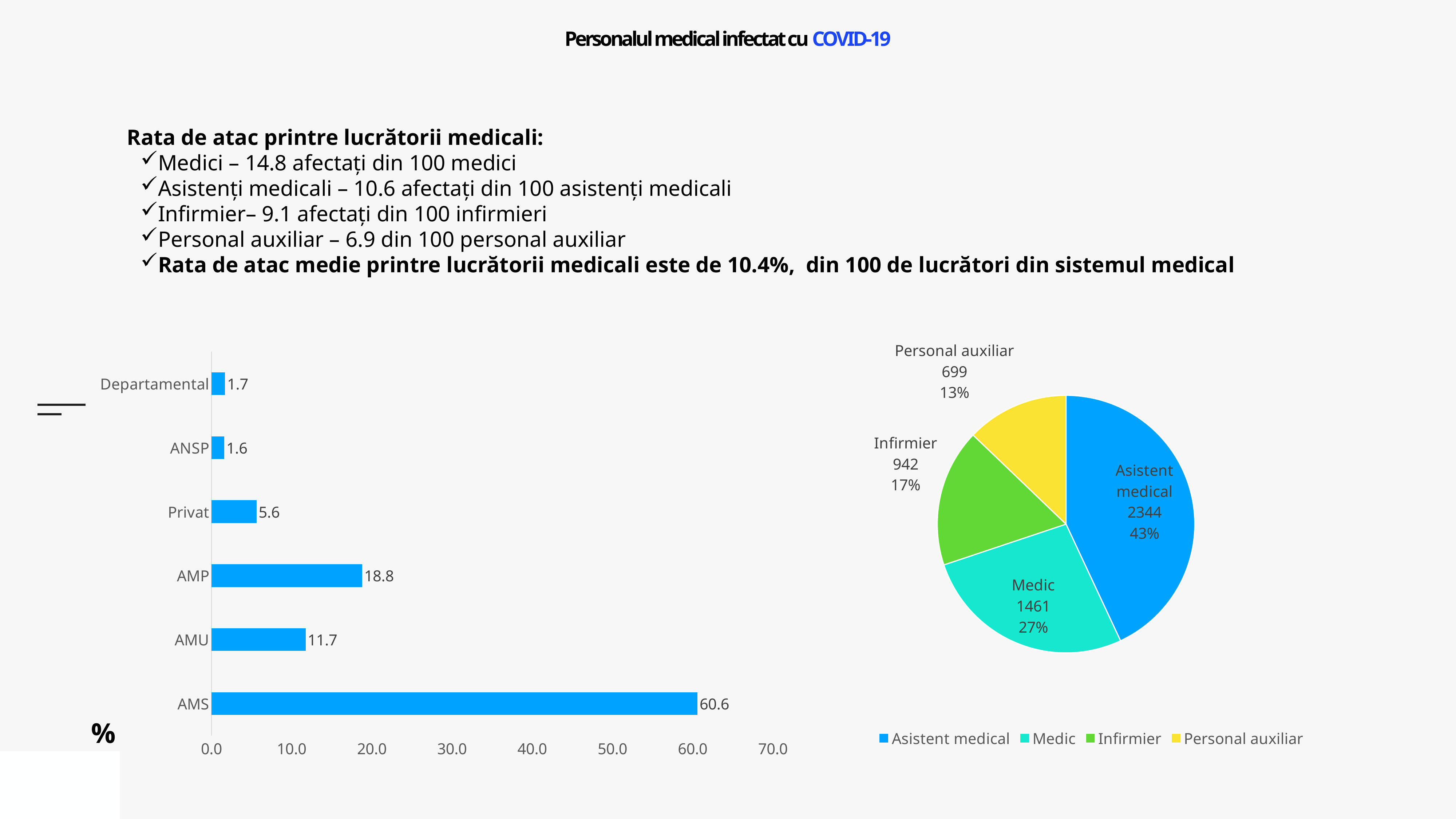
In the bar chart on the left, what is the difference between the values for AMP and AMU? 7.1 In the bar chart on the left, which category has the lowest value? ANSP In the bar chart on the left, which is larger, the value for Privat or the value for AMU? AMU What kind of chart is the chart on the left of the slide? Bar chart In the bar chart on the left, what is the value for AMP? 18.8 How many entries does the legend of the pie chart on the right list? 4 In the bar chart on the left, what is the value for AMS? 60.6 In the pie chart on the right, which category has the largest slice? Asistent medical In the pie chart on the right, what share of the pie does Infirmier represent? 17% In the pie chart on the right, what is the value for Medic? 1461 In the bar chart on the left, how many categories are shown? 6 In the bar chart on the left, which category has the highest value? AMS